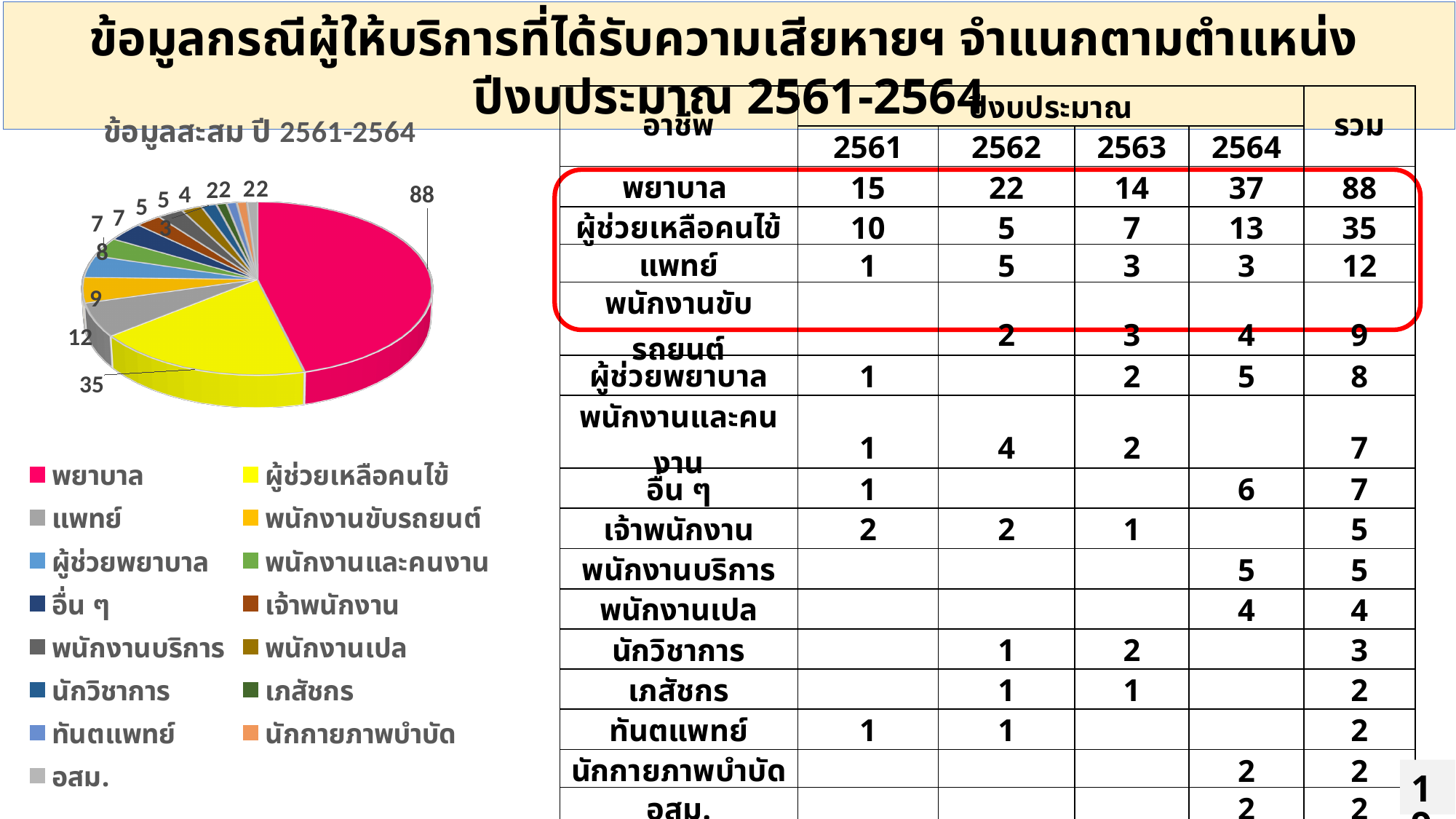
In the pie chart, what is the difference between the values for พยาบาล and ผู้ช่วยเหลือคนไข้? 53 In the pie chart, what is the value for ผู้ช่วยพยาบาล? 8 What type of chart is shown on the left of the slide? pie chart In the pie chart, what is the value for พยาบาล? 88 In the pie chart, what colour is the slice for ผู้ช่วยเหลือคนไข้? yellow How many categories does the pie chart's legend list? 15 What is the title of the pie chart? ข้อมูลสะสม ปี 2561-2564 In the pie chart, which is larger: แพทย์ or พนักงานขับรถยนต์? แพทย์ In the pie chart, what is the value for ผู้ช่วยเหลือคนไข้? 35 Which category has the largest slice in the pie chart? พยาบาล In the pie chart, what is the value for พนักงานขับรถยนต์? 9 In the pie chart, what is the value for แพทย์? 12